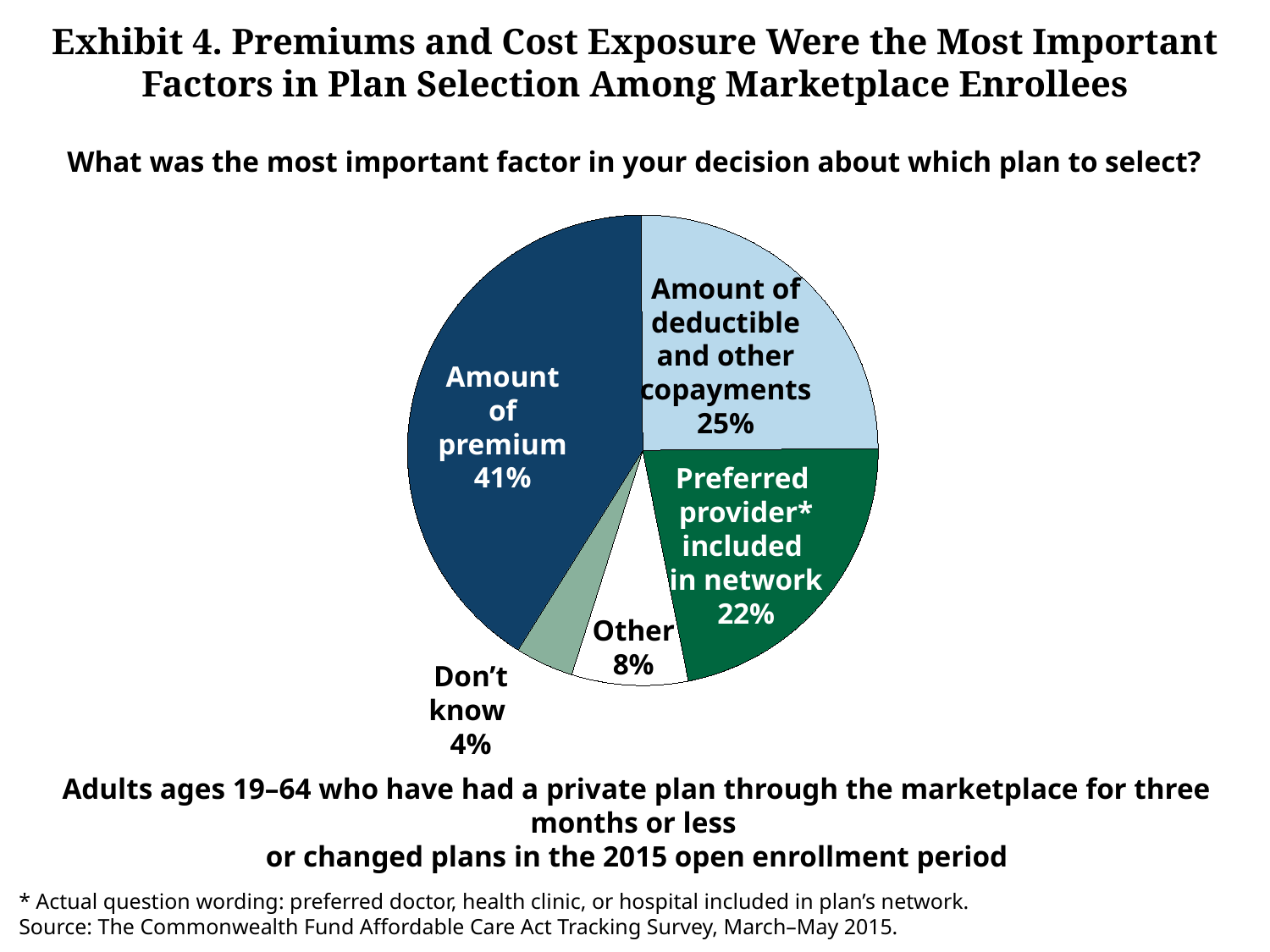
Which is larger: the share for 'Other' or the share for 'Don't know'? Other What percentage is shown for 'Amount of deductible and other copayments'? 25% Which category has the smallest slice of the pie? Don't know Which factor has the largest slice of the pie? Amount of premium What kind of chart is shown on the slide? Pie chart What percentage of respondents answered 'Don't know'? 4% What share of the pie is labelled 'Preferred provider* included in network'? 22% What percentage of respondents said the amount of premium was the most important factor? 41% What is the difference in percentage points between 'Amount of premium' and 'Amount of deductible and other copayments'? 16 What is the combined share of 'Amount of premium' and 'Amount of deductible and other copayments'? 66% What colour is the 'Preferred provider* included in network' slice? Green How many slices does the pie chart have? 5